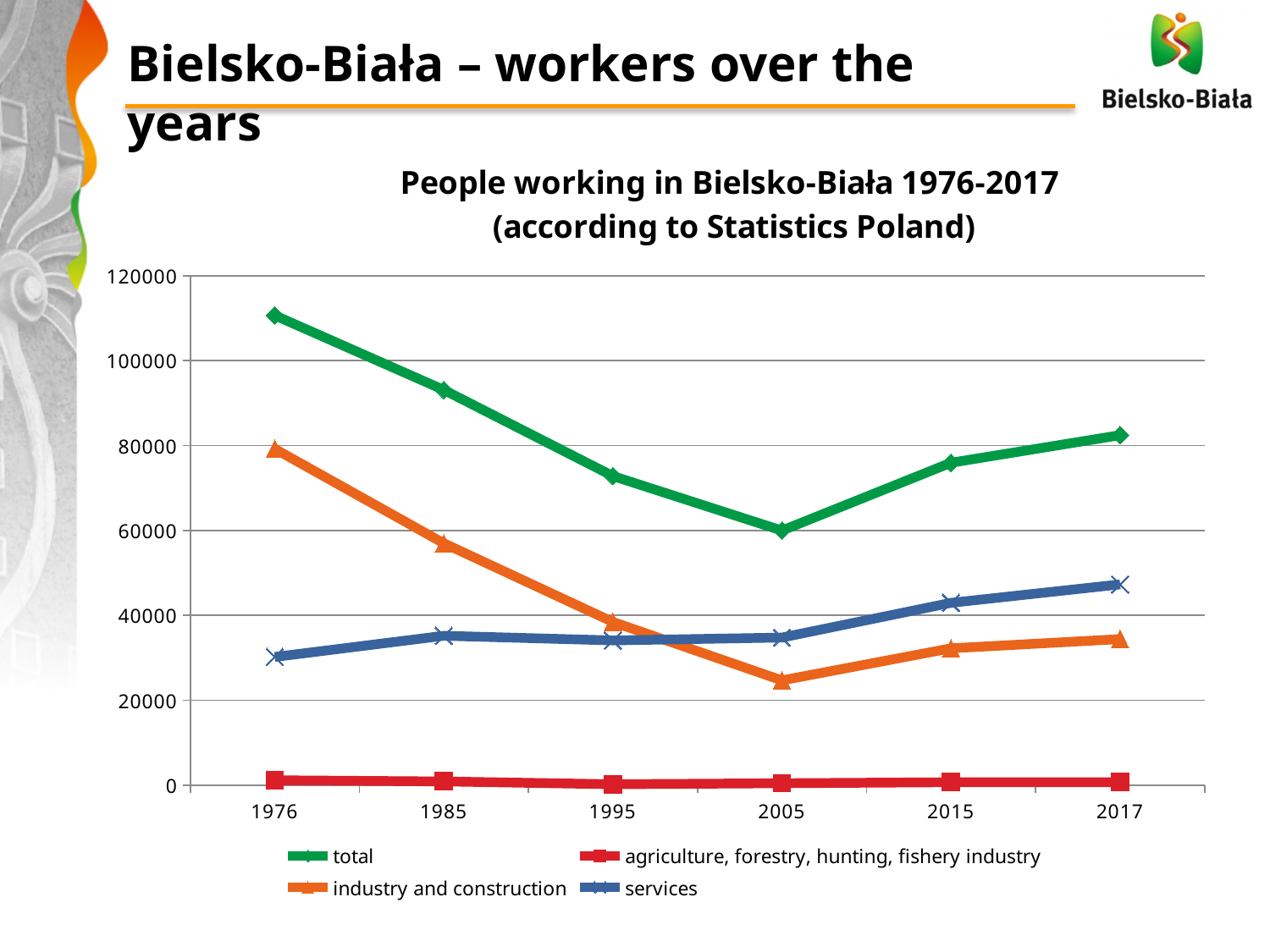
In 2017, which is larger: services or industry and construction? services What is the title of the chart? People working in Bielsko-Biała 1976-2017 (according to Statistics Poland) How many years are plotted along the x axis? 6 In which year is the total number of workers highest? 1976 Is the value for total in 1976 greater or less than 100000? greater In which year is the total number of workers lowest? 2005 Is the value for industry and construction in 2005 greater or less than 40000? less In 1976, which is larger: industry and construction or services? industry and construction What kind of chart is shown on the slide? line chart Does the total series rise or fall from 1976 to 2005? fall How many series does the legend list? 4 Is the value for services in 2017 greater or less than 40000? greater